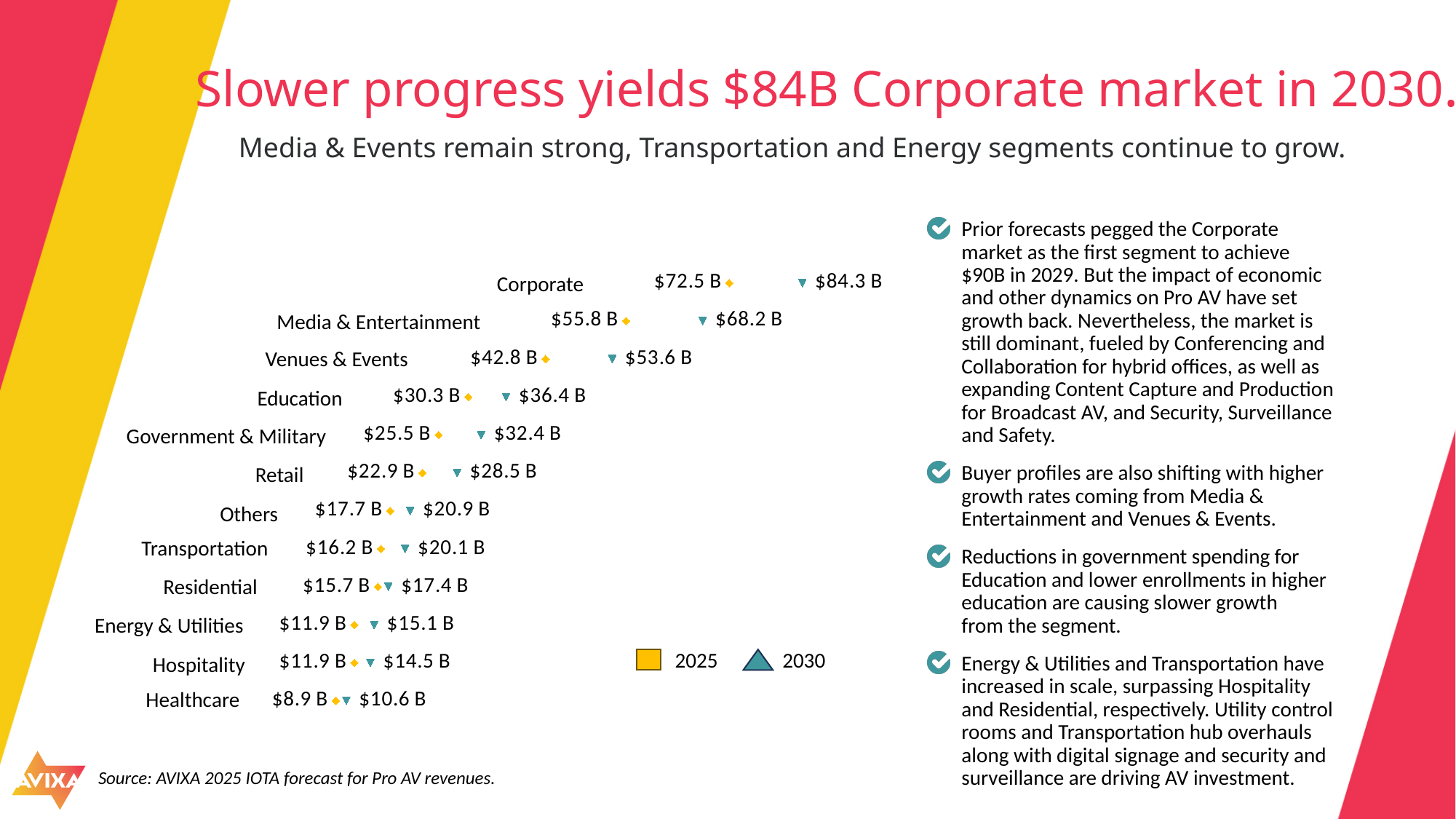
How many segments are shown in the chart? 12 Which is larger, the 2030 value for Transportation or the 2030 value for Residential? Transportation What is the difference between the 2030 and 2025 values for Venues & Events? $10.8 B What is the difference between the 2025 values for Corporate and Media & Entertainment? $16.7 B Which segment has the lowest 2025 value? Healthcare What is the 2025 value for Hospitality? $11.9 B What is the 2030 value for Corporate? $84.3 B Which segment has the highest 2030 value? Corporate How many series does the legend list? 2 What is the 2030 value for Energy & Utilities? $15.1 B What is the 2025 value for Media & Entertainment? $55.8 B Which years are listed in the chart legend? 2025 and 2030